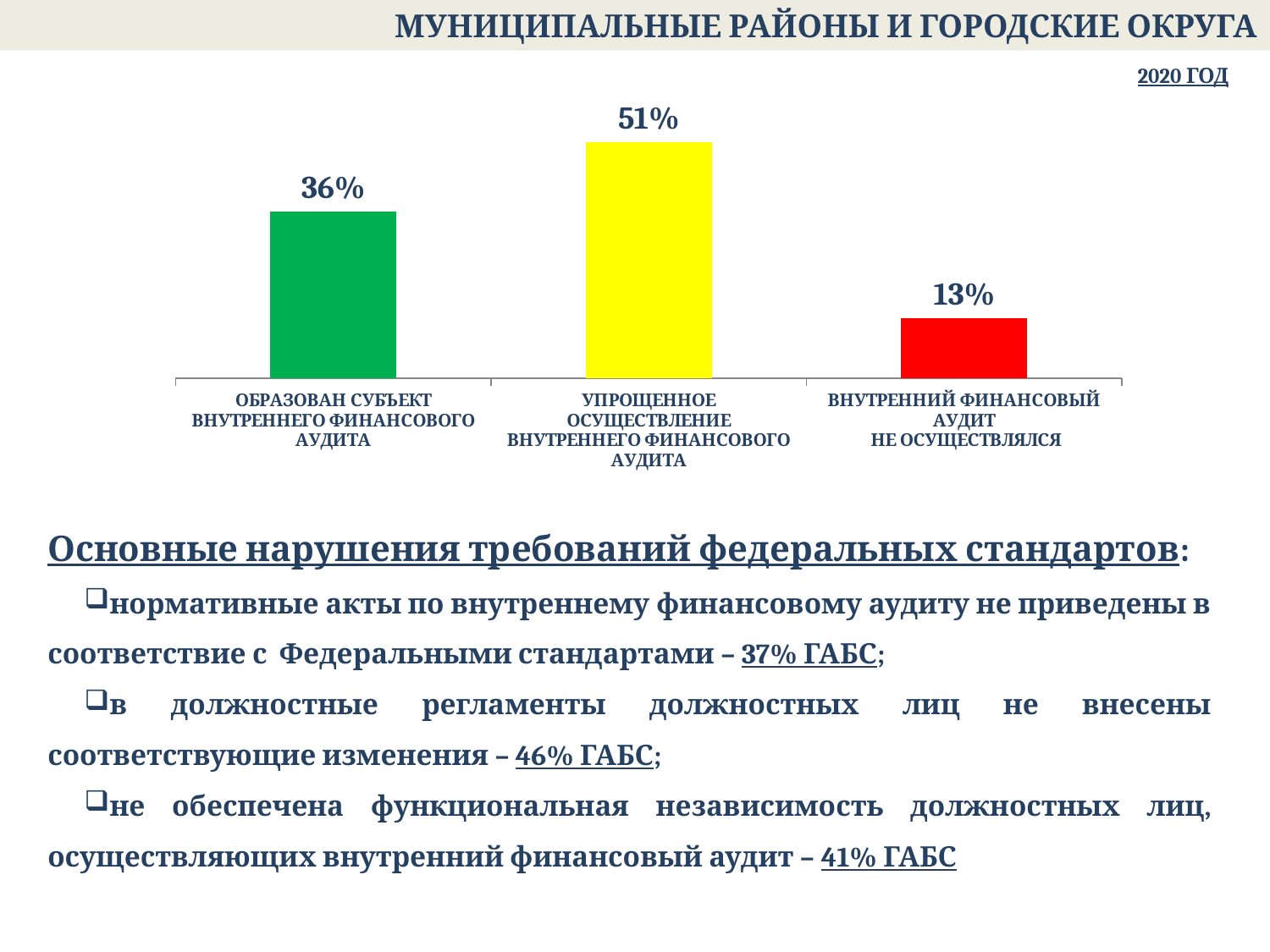
What is the value for «Внутренний финансовый аудит не осуществлялся»? 13% What year does the chart refer to, according to the label above it? 2020 год How many categories are shown in the chart? 3 What kind of chart is shown on the slide? Bar chart Which category has the highest value? Упрощенное осуществление внутреннего финансового аудита Which is larger: the value for «Образован субъект внутреннего финансового аудита» or for «Внутренний финансовый аудит не осуществлялся»? Образован субъект внутреннего финансового аудита Which category has the lowest value? Внутренний финансовый аудит не осуществлялся What is the value for «Упрощенное осуществление внутреннего финансового аудита»? 51% What is the difference between the values for «Упрощенное осуществление внутреннего финансового аудита» and «Образован субъект внутреннего финансового аудита»? 15% What colour is the bar for «Внутренний финансовый аудит не осуществлялся»? Red What is the value for «Образован субъект внутреннего финансового аудита»? 36% What is the difference between the values for «Образован субъект внутреннего финансового аудита» and «Внутренний финансовый аудит не осуществлялся»? 23%